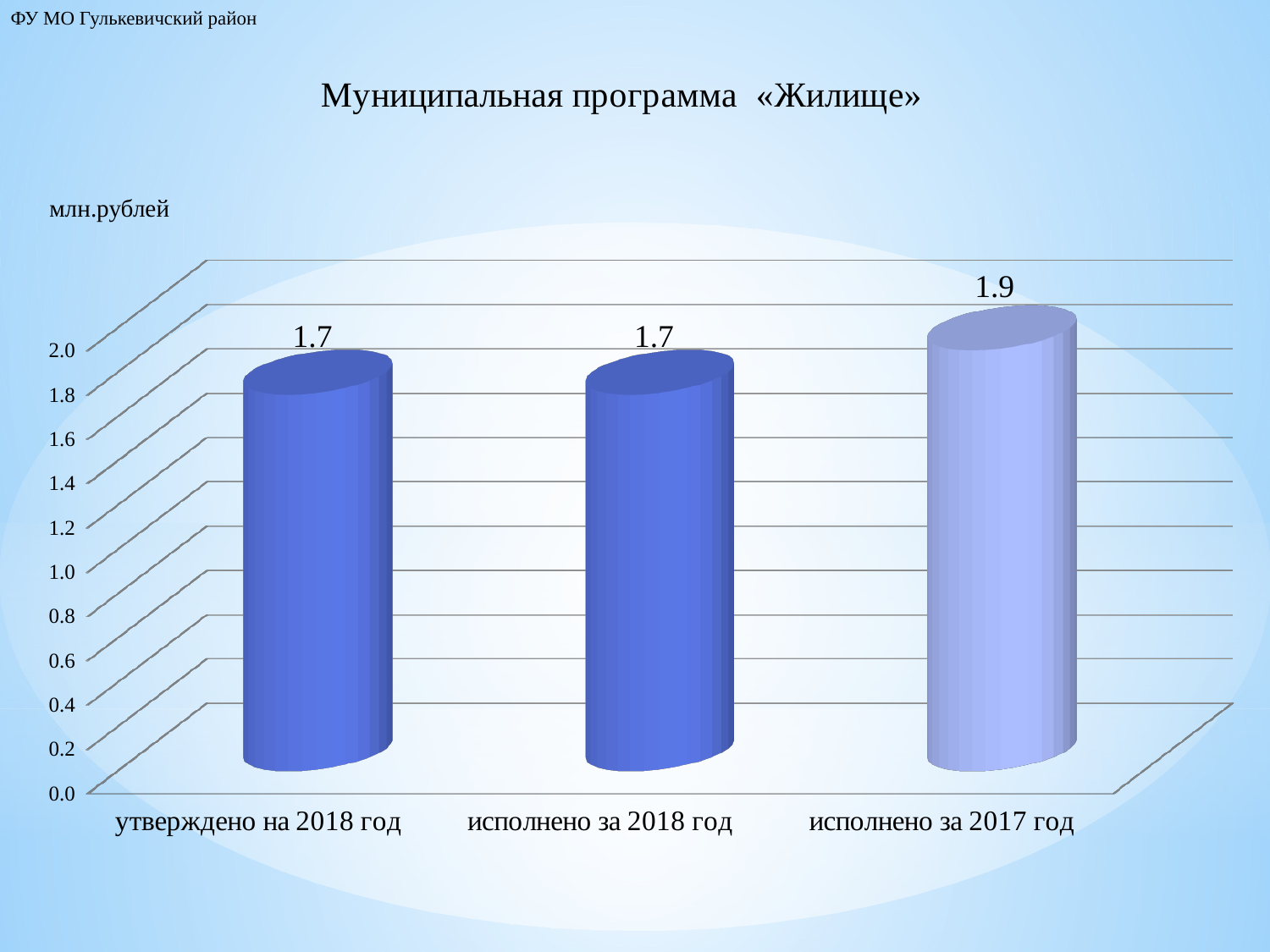
What is the value for «исполнено за 2018 год»? 1.7 What kind of chart is shown on the slide? bar chart What is the value for «исполнено за 2017 год»? 1.9 What is the value for «утверждено на 2018 год»? 1.7 Which category has the highest value? исполнено за 2017 год Which is larger: the value for «исполнено за 2017 год» or the value for «утверждено на 2018 год»? исполнено за 2017 год Is the value for «исполнено за 2017 год» greater or less than 1.8? greater Is the value for «утверждено на 2018 год» greater or less than 1.0? greater What is the title of the chart? Муниципальная программа «Жилище» What unit is shown for the values on the chart? млн.рублей What is the difference between the value for «исполнено за 2017 год» and the value for «исполнено за 2018 год»? 0.2 How many categories are shown on the chart? 3